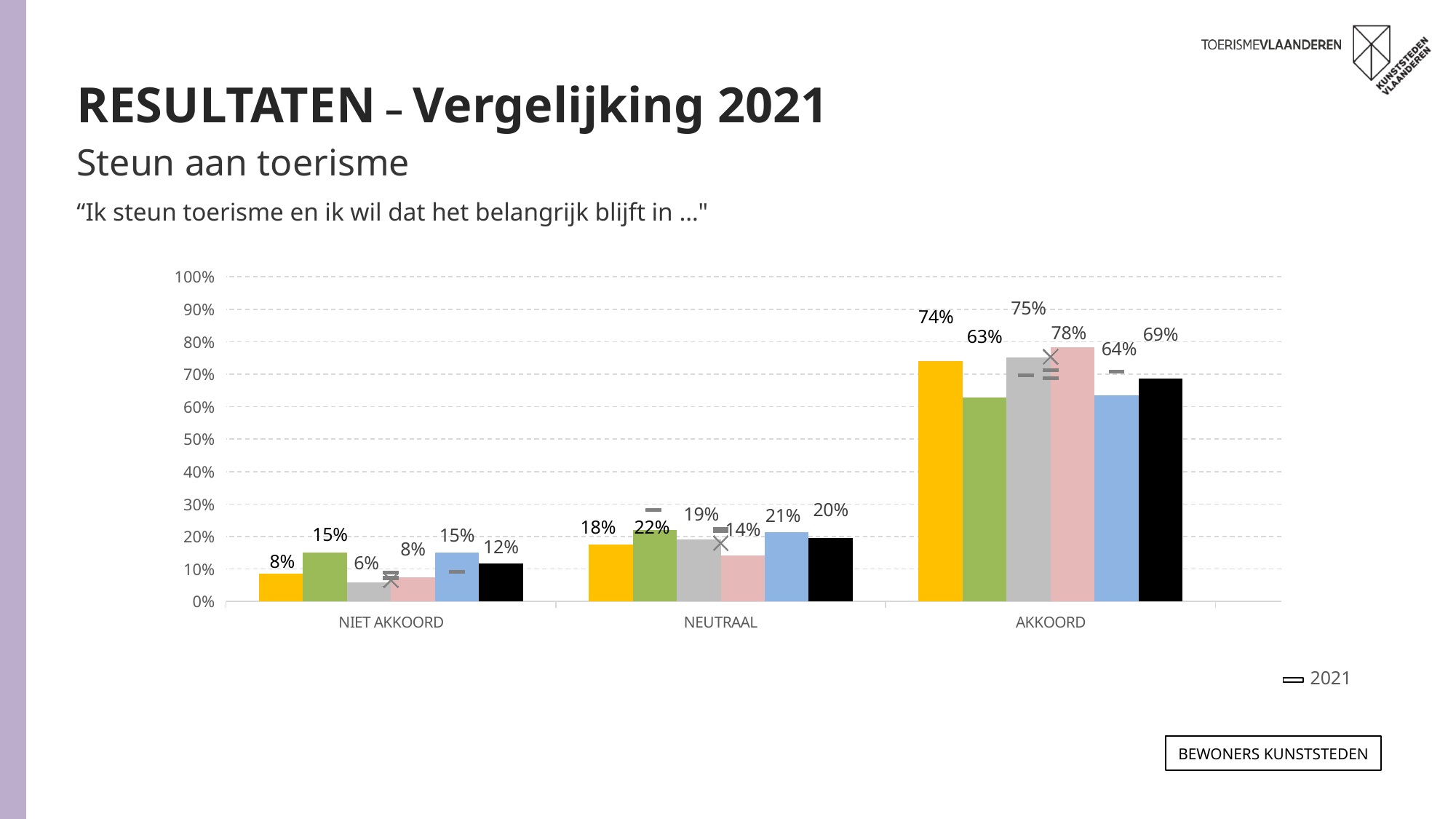
What kind of chart is shown on the slide? Bar chart How many categories are shown on the x axis? 3 Do the values of the yellow bar rise or fall from NIET AKKOORD to AKKOORD? Rise What is the difference between the yellow bar's value in AKKOORD and its value in NIET AKKOORD? 66 percentage points What value is shown for the pink bar in the NEUTRAAL category? 14% Is the value of the green bar in the AKKOORD category greater or less than 70%? less Which bar has the lowest value in the NIET AKKOORD category? The grey bar (6%) What value is shown for the yellow bar in the AKKOORD category? 74% In the AKKOORD category, which is larger: the black bar or the blue bar? The black bar (69%) What year does the legend marker below the chart refer to? 2021 Which bar has the highest value in the AKKOORD category? The pink bar (78%) What value is shown for the black bar in the NIET AKKOORD category? 12%